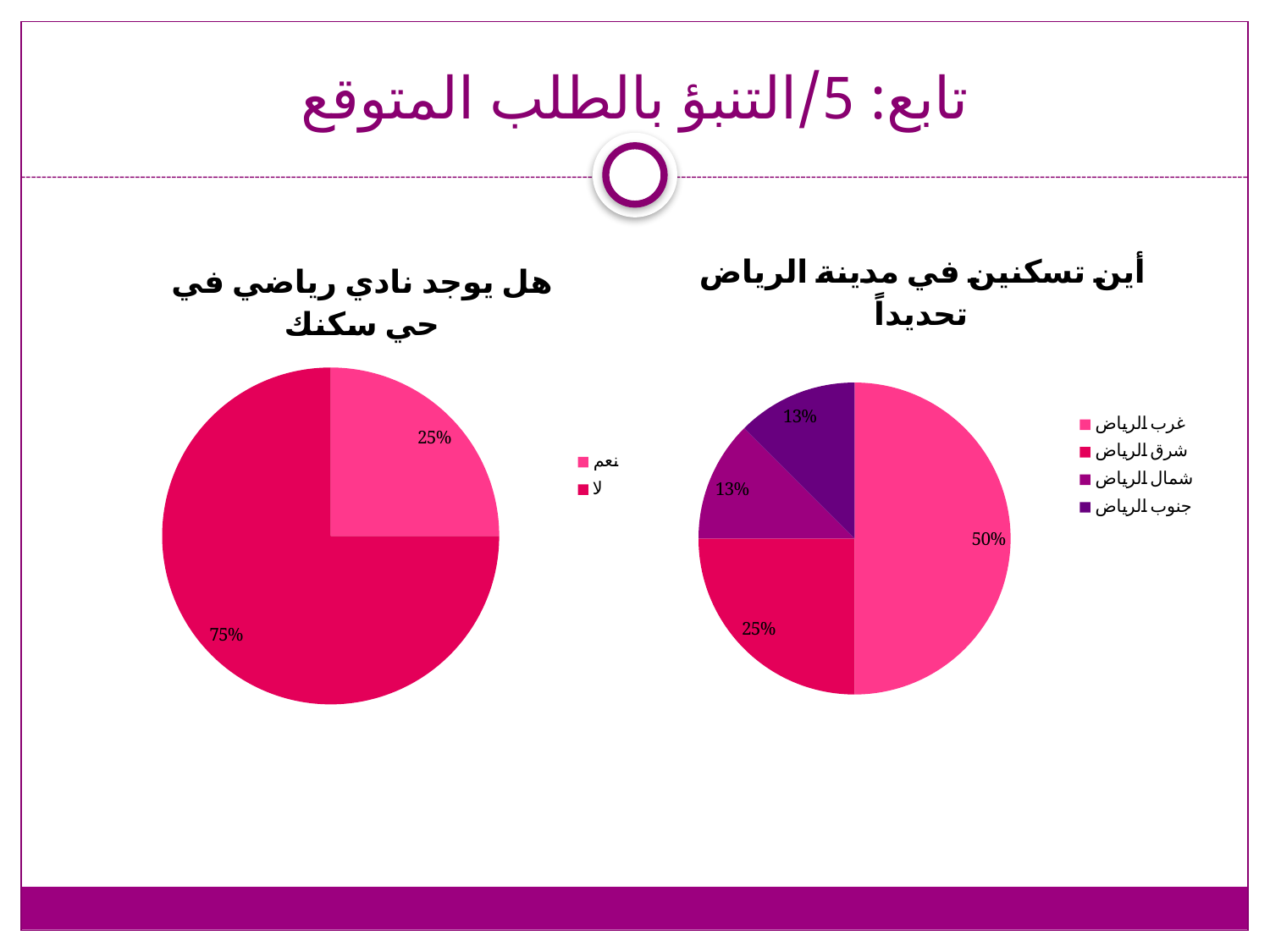
In the pie chart titled "أين تسكنين في مدينة الرياض تحديداً", which is larger: the share for شرق الرياض or the share for جنوب الرياض? شرق الرياض In the pie chart titled "أين تسكنين في مدينة الرياض تحديداً", what share is labelled for غرب الرياض? 50% In the pie chart titled "أين تسكنين في مدينة الرياض تحديداً", what share is labelled for شرق الرياض? 25% In the pie chart titled "هل يوجد نادي رياضي في حي سكنك", which category has the smallest slice? نعم In the pie chart titled "أين تسكنين في مدينة الرياض تحديداً", how many categories does the legend list? 4 In the pie chart titled "هل يوجد نادي رياضي في حي سكنك", what share is labelled for لا? 75% In the pie chart titled "أين تسكنين في مدينة الرياض تحديداً", which category has the largest slice? غرب الرياض In the pie chart titled "أين تسكنين في مدينة الرياض تحديداً", what is the difference between the shares for غرب الرياض and شرق الرياض? 25% In the pie chart titled "هل يوجد نادي رياضي في حي سكنك", how many categories does the legend list? 2 In the pie chart titled "أين تسكنين في مدينة الرياض تحديداً", what share is labelled for شمال الرياض? 13% In the pie chart titled "هل يوجد نادي رياضي في حي سكنك", what share is labelled for نعم? 25% What kind of chart is the chart on the left of the slide? Pie chart